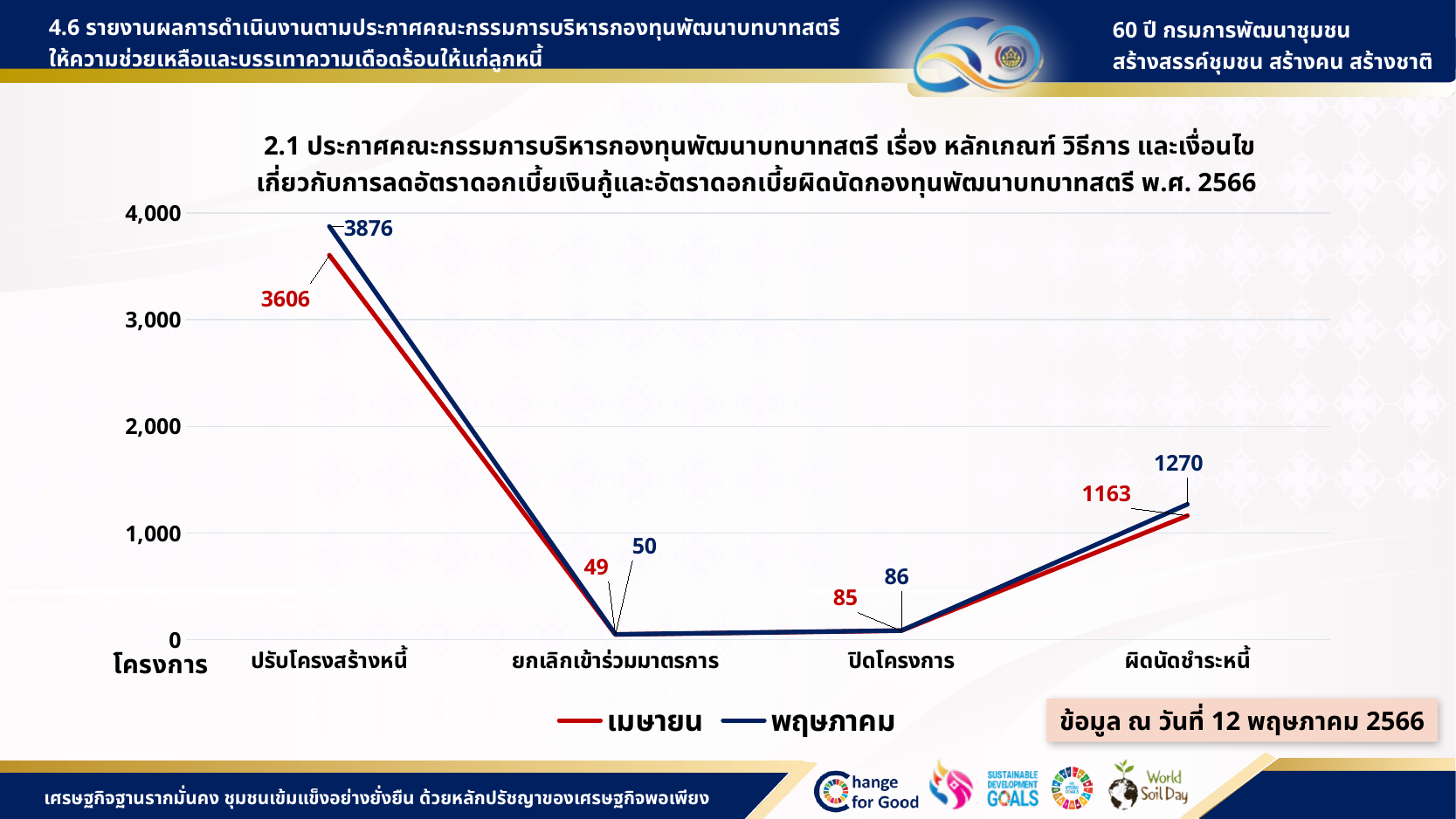
What is the difference between the พฤษภาคม and เมษายน values for ปรับโครงสร้างหนี้? 270 What is the value for ปรับโครงสร้างหนี้ in the เมษายน series? 3606 What is the value for ปิดโครงการ in the เมษายน series? 85 Which category has the highest value in the พฤษภาคม series? ปรับโครงสร้างหนี้ How many series does the legend list? 2 Which category has the lowest value in the เมษายน series? ยกเลิกเข้าร่วมมาตรการ What is the difference between the พฤษภาคม and เมษายน values for ผิดนัดชำระหนี้? 107 What is the value for ผิดนัดชำระหนี้ in the พฤษภาคม series? 1270 Which is larger for ผิดนัดชำระหนี้: the เมษายน value or the พฤษภาคม value? พฤษภาคม How many categories are shown on the x axis? 4 What kind of chart is shown on the slide? Line chart What is the value for ปรับโครงสร้างหนี้ in the พฤษภาคม series? 3876